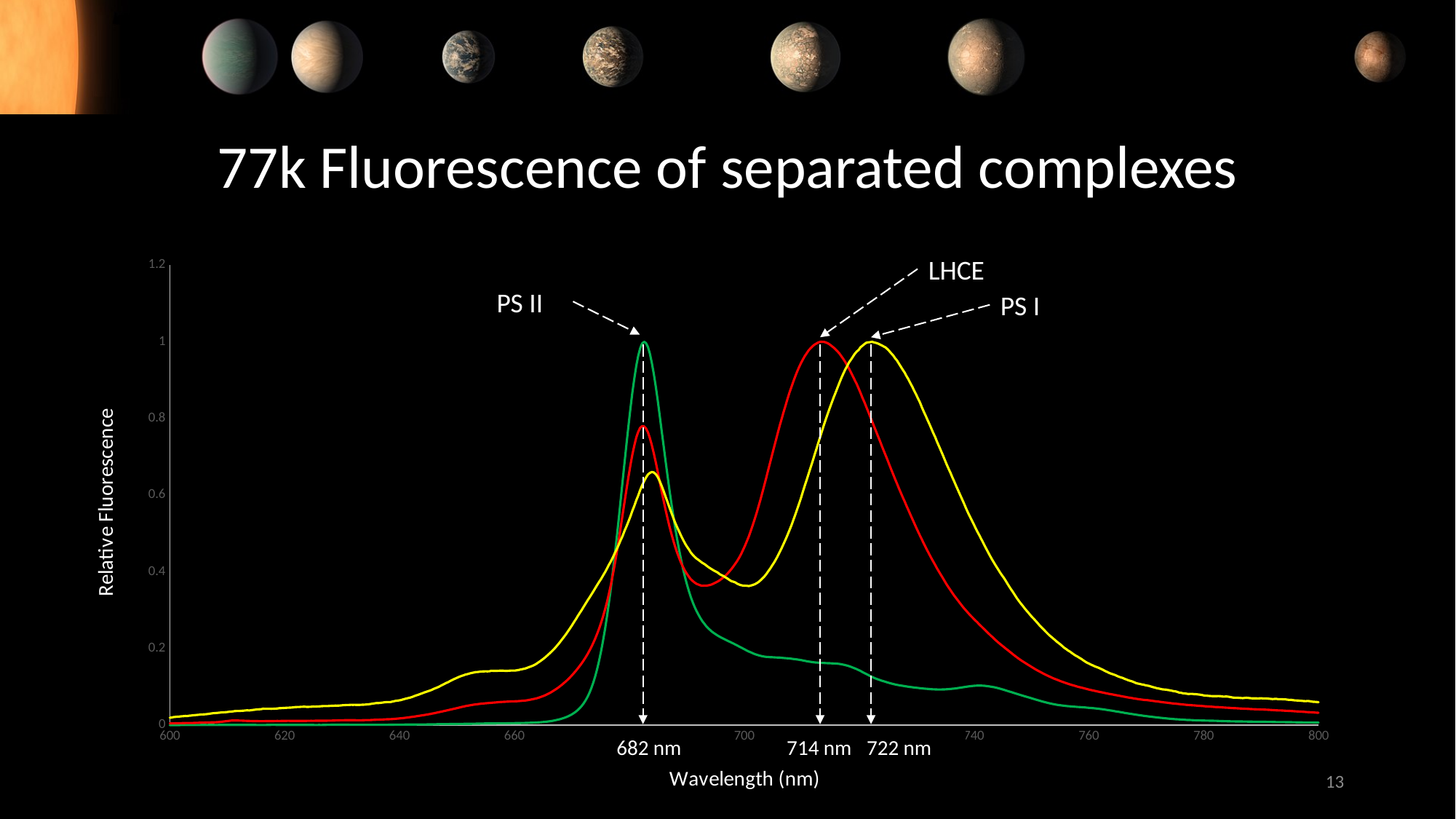
What is the difference in wavelength between the PS I peak and the PS II peak? 40 nm At what wavelength does the PS II curve peak, according to the annotation? 682 nm What kind of chart is shown on the slide? Line chart What is the label of the x axis of the chart? Wavelength (nm) Which complex has its peak at the longest wavelength? PS I Is the relative fluorescence of the PS II curve at 740 nm greater or less than 0.2? less Which complex has its peak at the shortest wavelength? PS II At what wavelength does the LHCE curve peak, according to the annotation? 714 nm What is the title of the chart on the slide? 77k Fluorescence of separated complexes At what wavelength does the PS I curve peak, according to the annotation? 722 nm At 682 nm, which curve has the higher relative fluorescence, PS II or LHCE? PS II How many curves (complexes) are plotted on the chart? 3